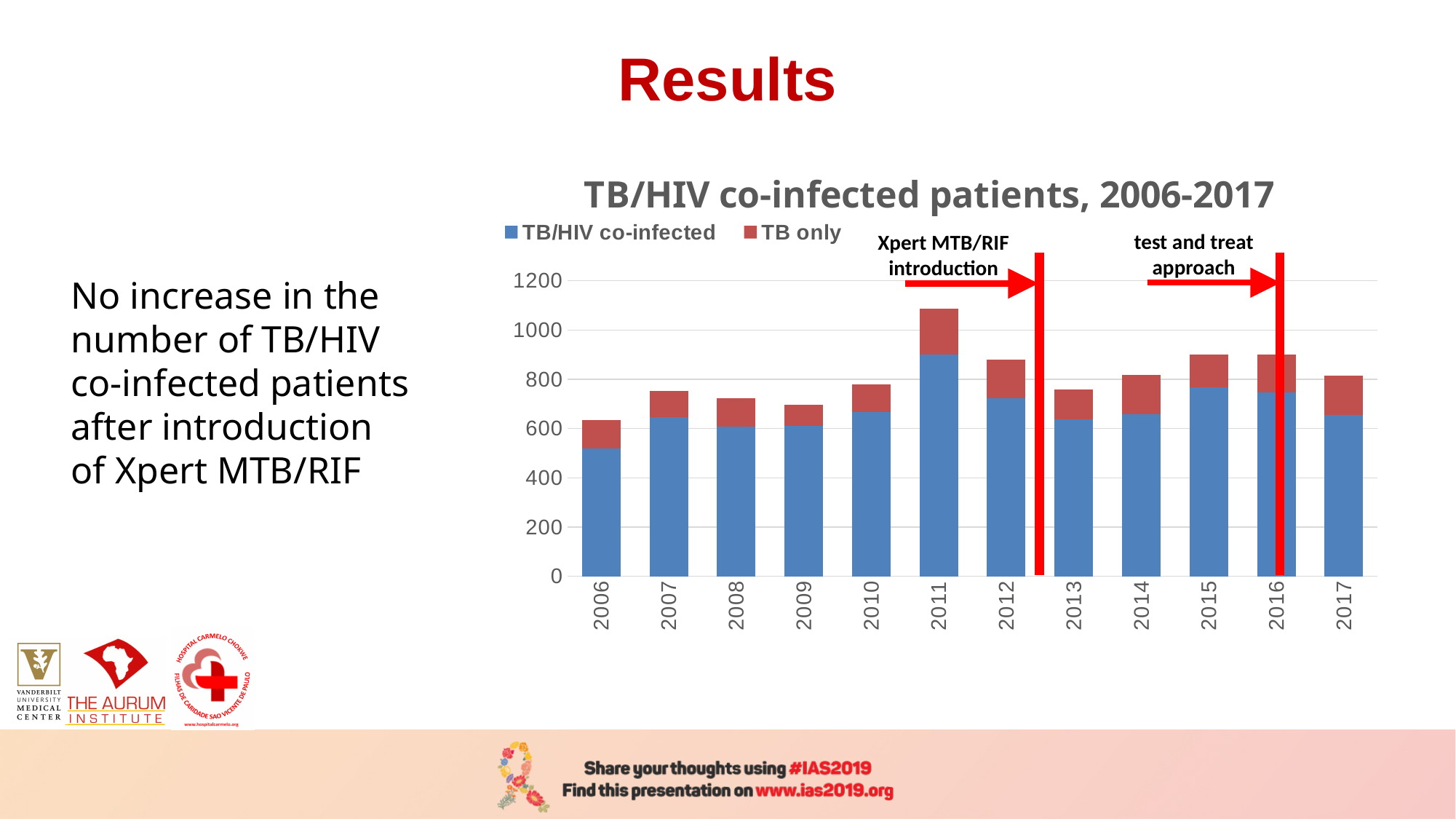
Is the TB/HIV co-infected value for 2006 greater or less than 600? less What are the two series named in the legend? TB/HIV co-infected and TB only How many years are shown along the x axis of the chart? 12 What is the title of the chart? TB/HIV co-infected patients, 2006-2017 Which year has the shortest stacked bar in the chart? 2006 Which year has the larger total bar, 2011 or 2012? 2011 What kind of chart is shown on the slide? Stacked bar chart Is the total height of the 2011 bar greater or less than 1000? greater Is the total height of the 2006 bar greater or less than 800? less Which year has the tallest stacked bar in the chart? 2011 How many series does the chart's legend list? 2